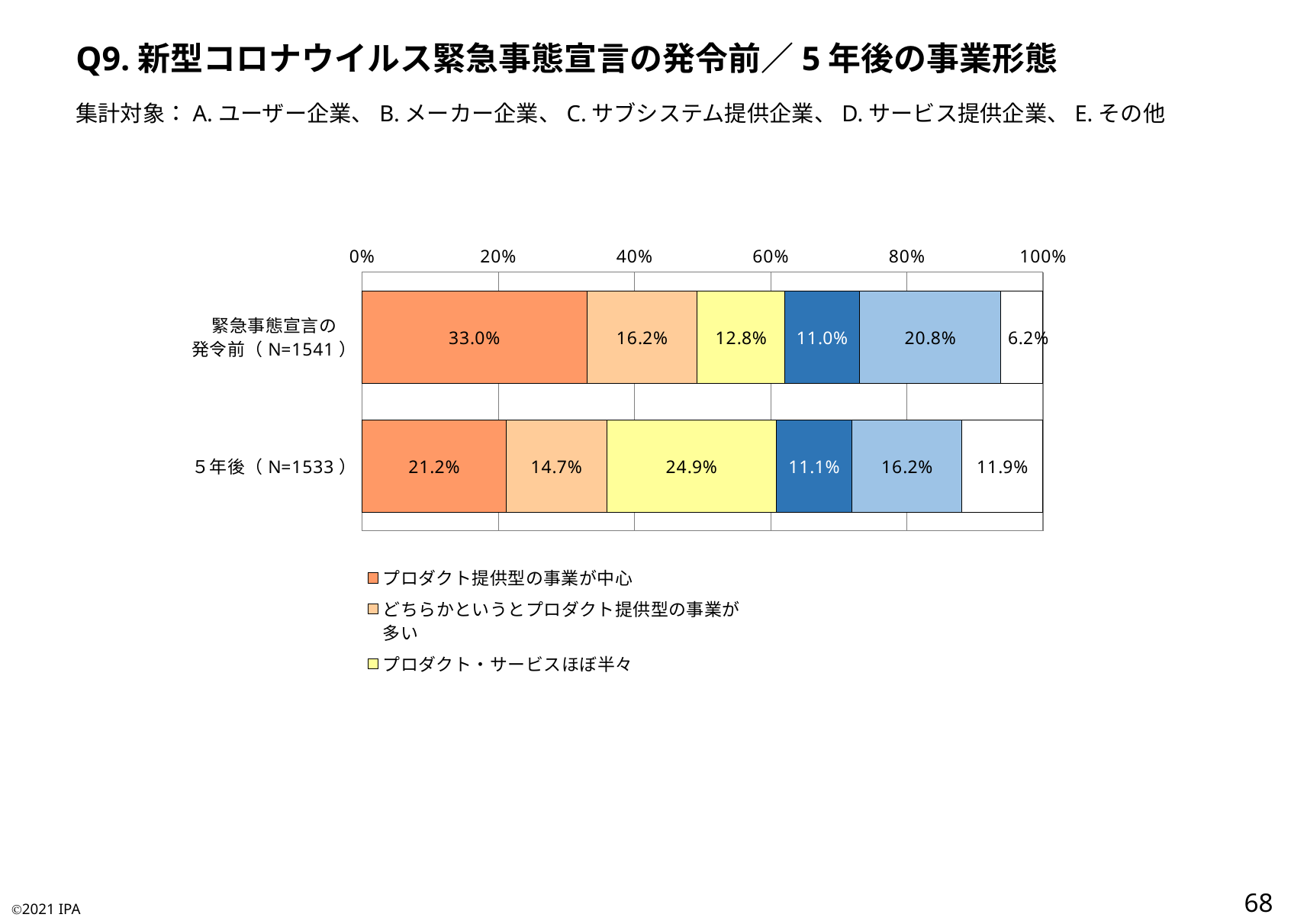
How many series entries are listed in the legend shown on the slide? 3 What is the value of プロダクト提供型の事業が中心 for 5年後 (N=1533)? 21.2% What is the value of プロダクト・サービスほぼ半々 for 緊急事態宣言の発令前 (N=1541)? 12.8% Which bar has the larger value for プロダクト・サービスほぼ半々, 緊急事態宣言の発令前 or 5年後? 5年後 What is the value of プロダクト提供型の事業が中心 for 緊急事態宣言の発令前 (N=1541)? 33.0% Which segment is the largest in the 5年後 (N=1533) bar? プロダクト・サービスほぼ半々 (24.9%) By how many percentage points does プロダクト提供型の事業が中心 differ between 緊急事態宣言の発令前 and 5年後? 11.8 percentage points What is the value of どちらかというとプロダクト提供型の事業が多い for 5年後 (N=1533)? 14.7% What kind of chart is shown on the slide? Stacked bar chart How many bars (categories) are plotted in the chart? 2 What is the value of プロダクト・サービスほぼ半々 for 5年後 (N=1533)? 24.9% Does the value of プロダクト提供型の事業が中心 rise or fall from 緊急事態宣言の発令前 to 5年後? Fall